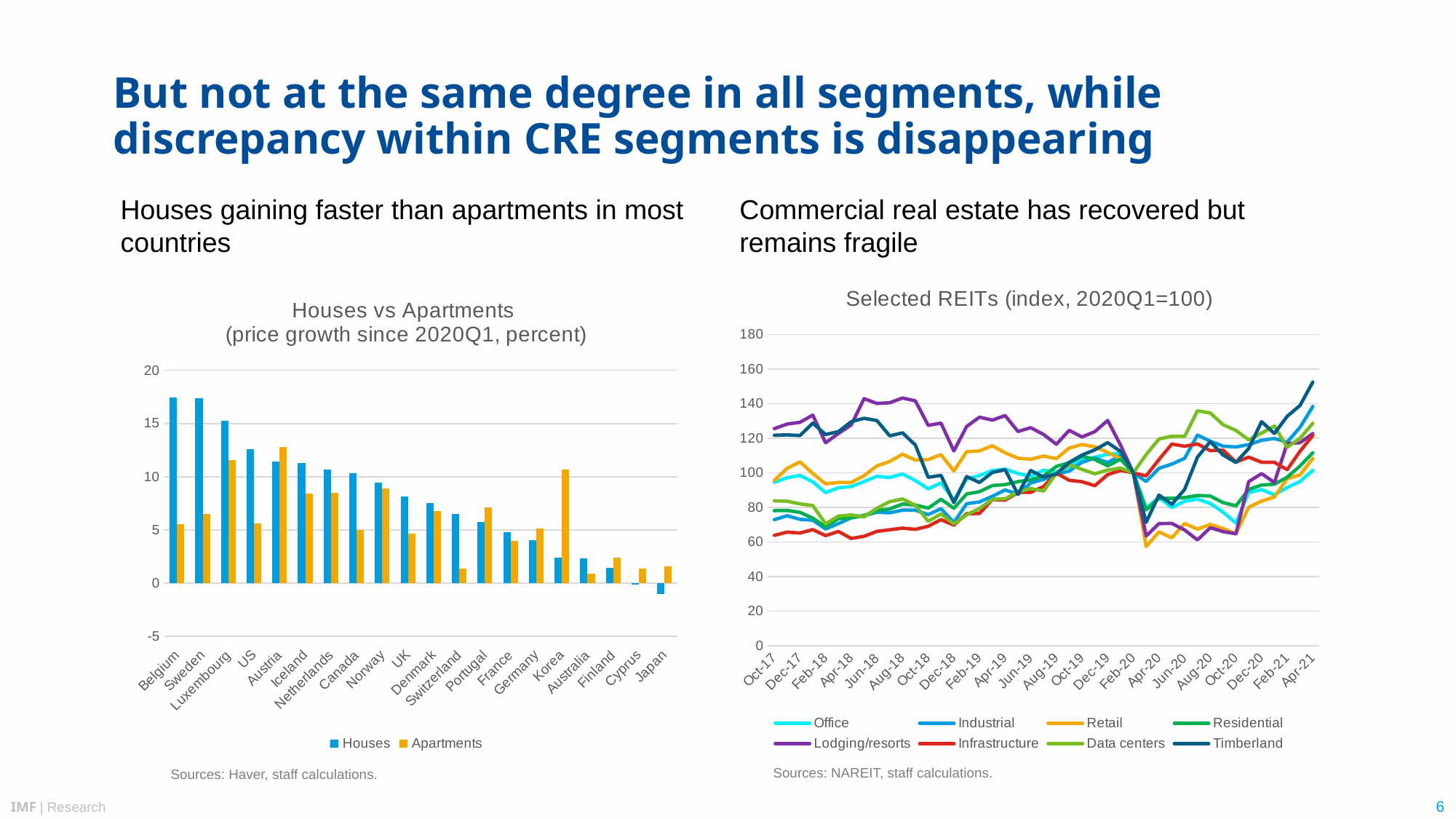
How many series does the legend of the 'Selected REITs' chart list? 8 How many countries are shown in the 'Houses vs Apartments' chart? 20 How many series does the legend of the 'Houses vs Apartments' chart list? 2 What type of chart is the 'Selected REITs' chart on the right? line chart In the 'Houses vs Apartments' chart, which is larger for Korea, Houses or Apartments? Apartments In the 'Selected REITs' chart, which series has the highest value at Apr-21? Timberland What type of chart is the 'Houses vs Apartments' chart on the left? bar chart In the 'Houses vs Apartments' chart, which country has the lowest Houses value? Japan In the 'Houses vs Apartments' chart, is the Houses value for Belgium greater or less than 15? greater In the 'Selected REITs' chart, which series has the lowest value at Apr-20? Retail In the 'Selected REITs' chart, is the Timberland value at Apr-21 greater or less than 140? greater In the 'Houses vs Apartments' chart, which country has the highest Apartments value? Austria